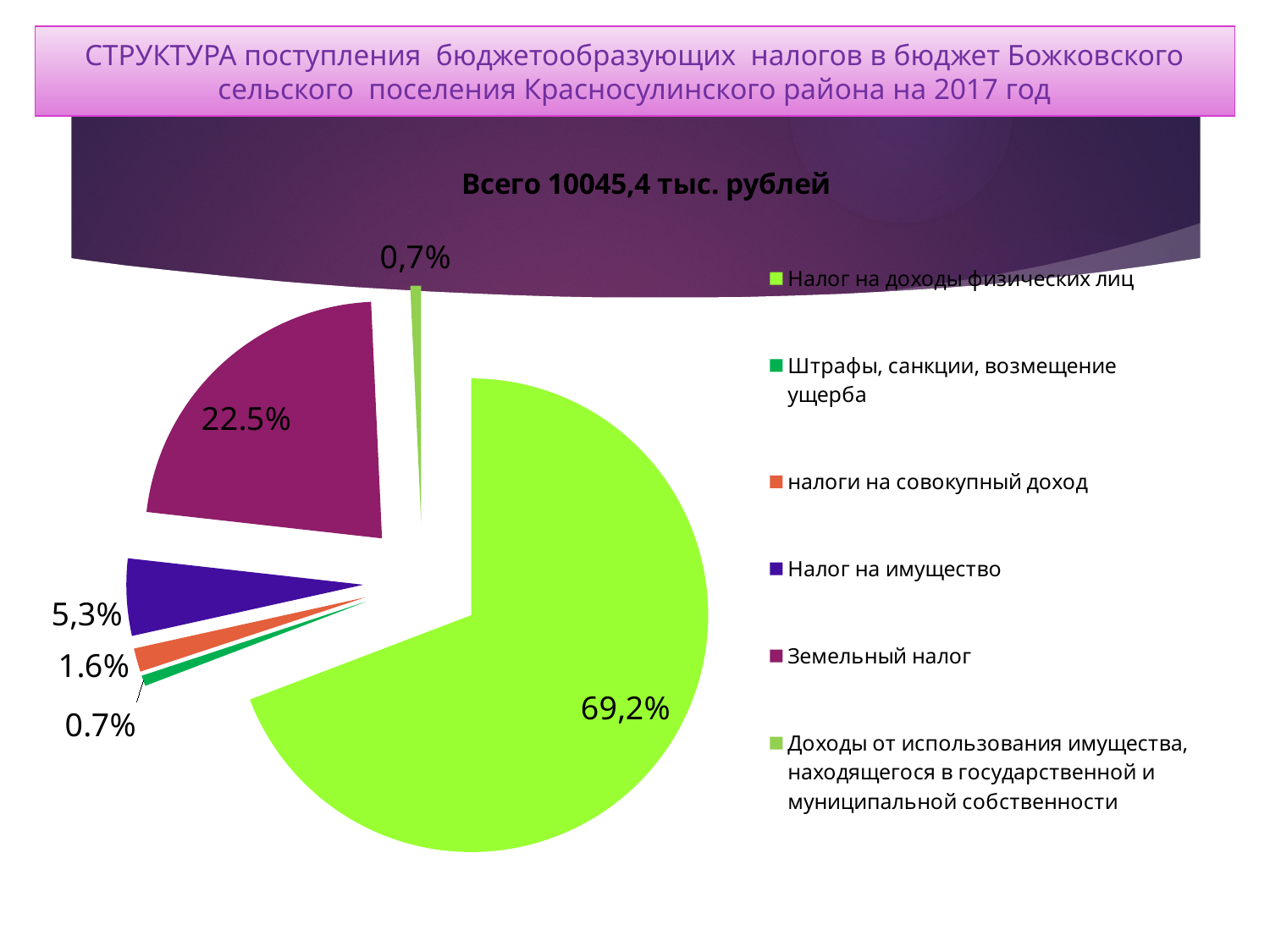
Which category has the largest slice of the pie? Налог на доходы физических лиц What is the value shown for Земельный налог? 22.5% How many slices does the pie chart have? 6 Which is larger, Земельный налог or Налог на имущество? Земельный налог What is the value shown for Налог на имущество? 5,3% What is the value shown for Штрафы, санкции, возмещение ущерба? 0.7% What is the value shown for налоги на совокупный доход? 1.6% What share of the pie does Налог на доходы физических лиц account for? 69,2% How many entries does the legend list? 6 What kind of chart is shown on the slide? Pie chart What total amount is stated above the chart? Всего 10045,4 тыс. рублей What colour is the slice for Налог на имущество? Dark purple